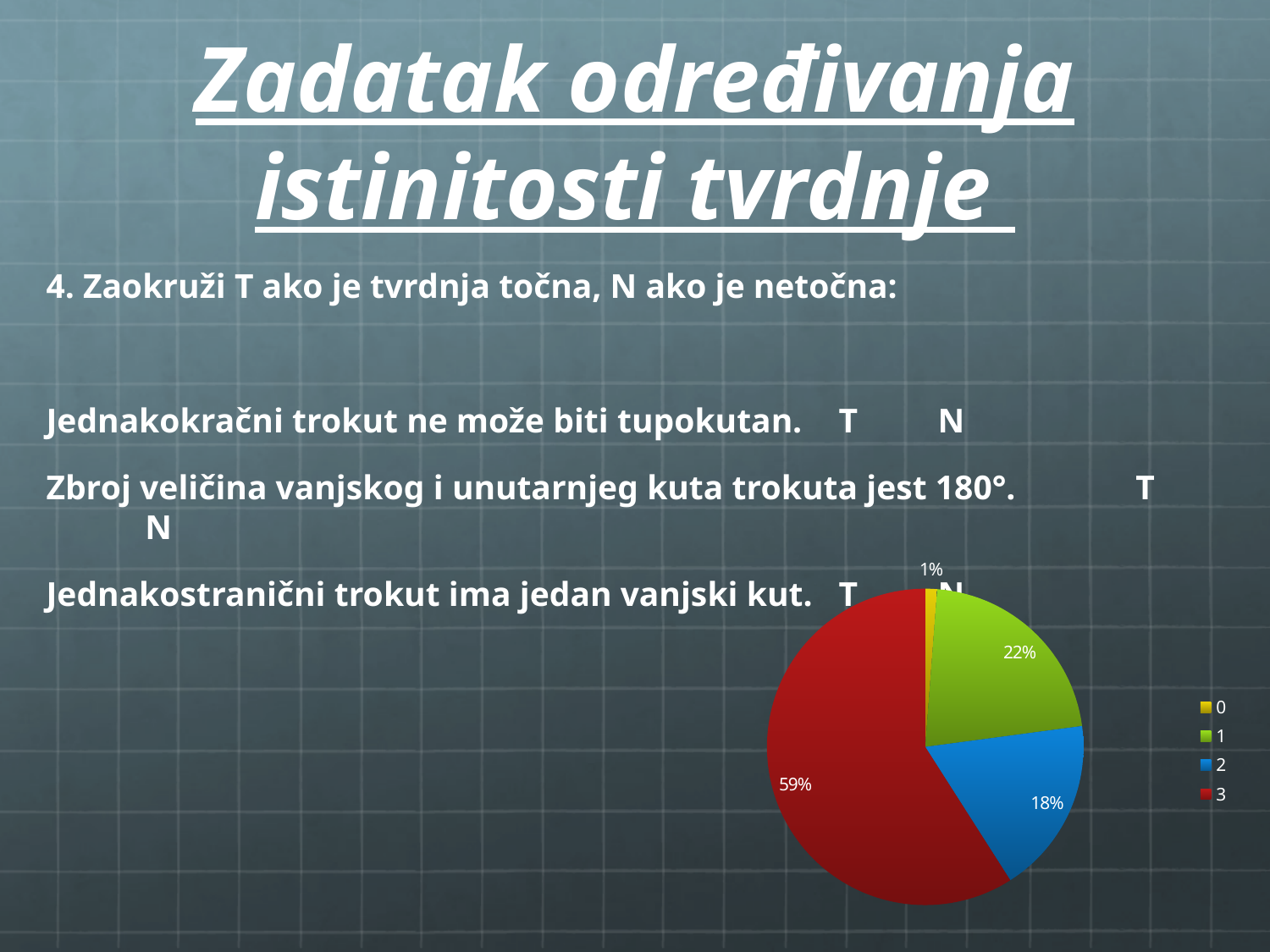
What share of the pie does category 1 have? 22% What kind of chart is shown on the slide? pie chart Which slice is larger, category 1 or category 2? 1 How many entries does the legend of the pie chart list? 4 What share of the pie does category 3 have? 59% What share of the pie does category 0 have? 1% Which category has the largest slice of the pie? 3 What colour is the slice for category 3 in the pie chart? red How many slices does the pie chart have? 4 Which category has the smallest slice of the pie? 0 What is the difference in percentage points between the slices for category 3 and category 1? 37